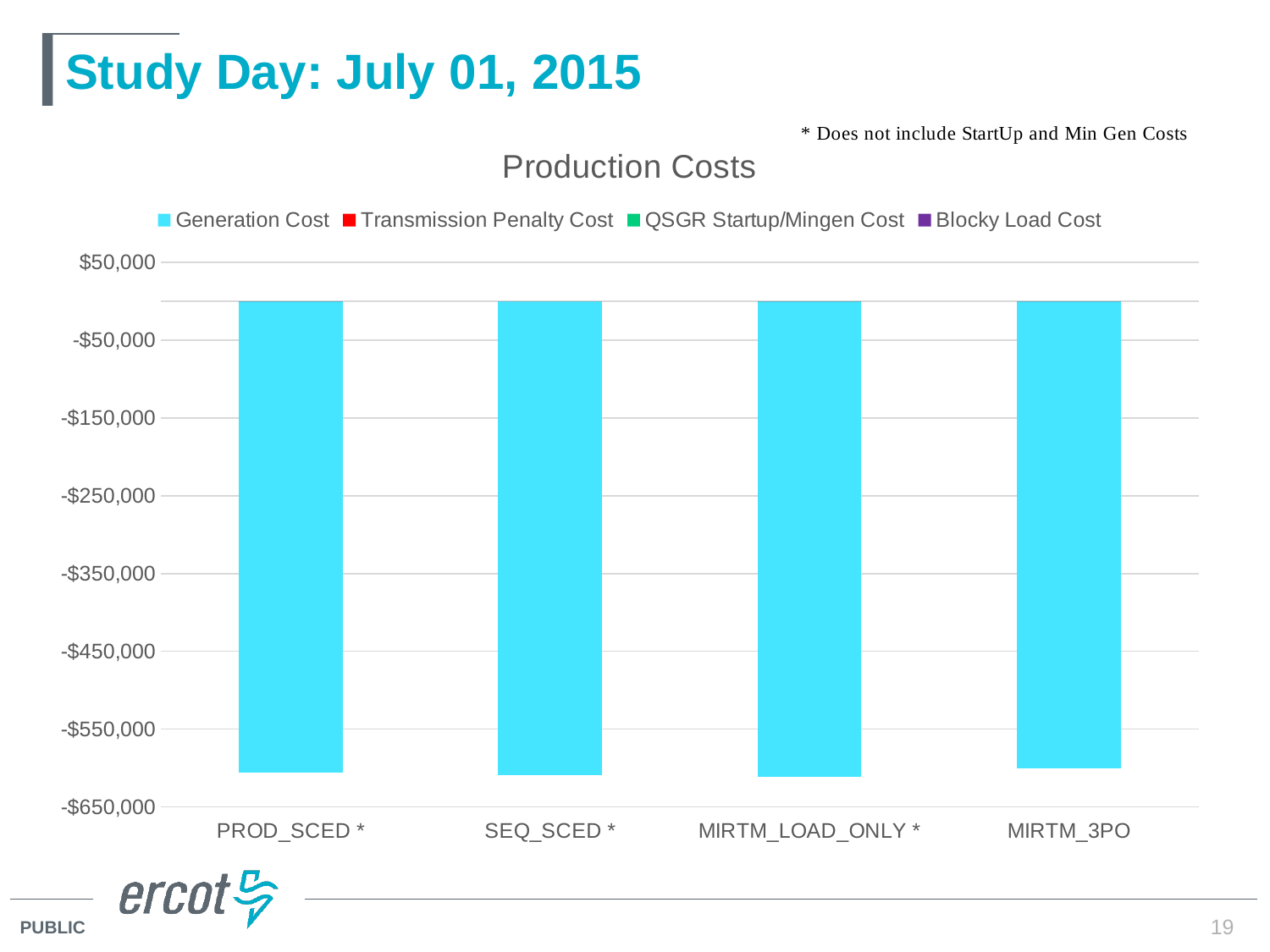
Is the Generation Cost value for SEQ_SCED * greater or less than -$650,000? greater What is the label of the last category on the x axis of the Production Costs chart? MIRTM_3PO Which series in the Production Costs chart is shown in light blue? Generation Cost What is the title of the chart on the slide? Production Costs Is the Generation Cost value for MIRTM_LOAD_ONLY * greater or less than -$550,000? less Is the Generation Cost value for MIRTM_3PO greater or less than -$450,000? less What kind of chart is shown on the slide? bar chart How many categories are shown on the x axis of the Production Costs chart? 4 How many series does the legend of the Production Costs chart list? 4